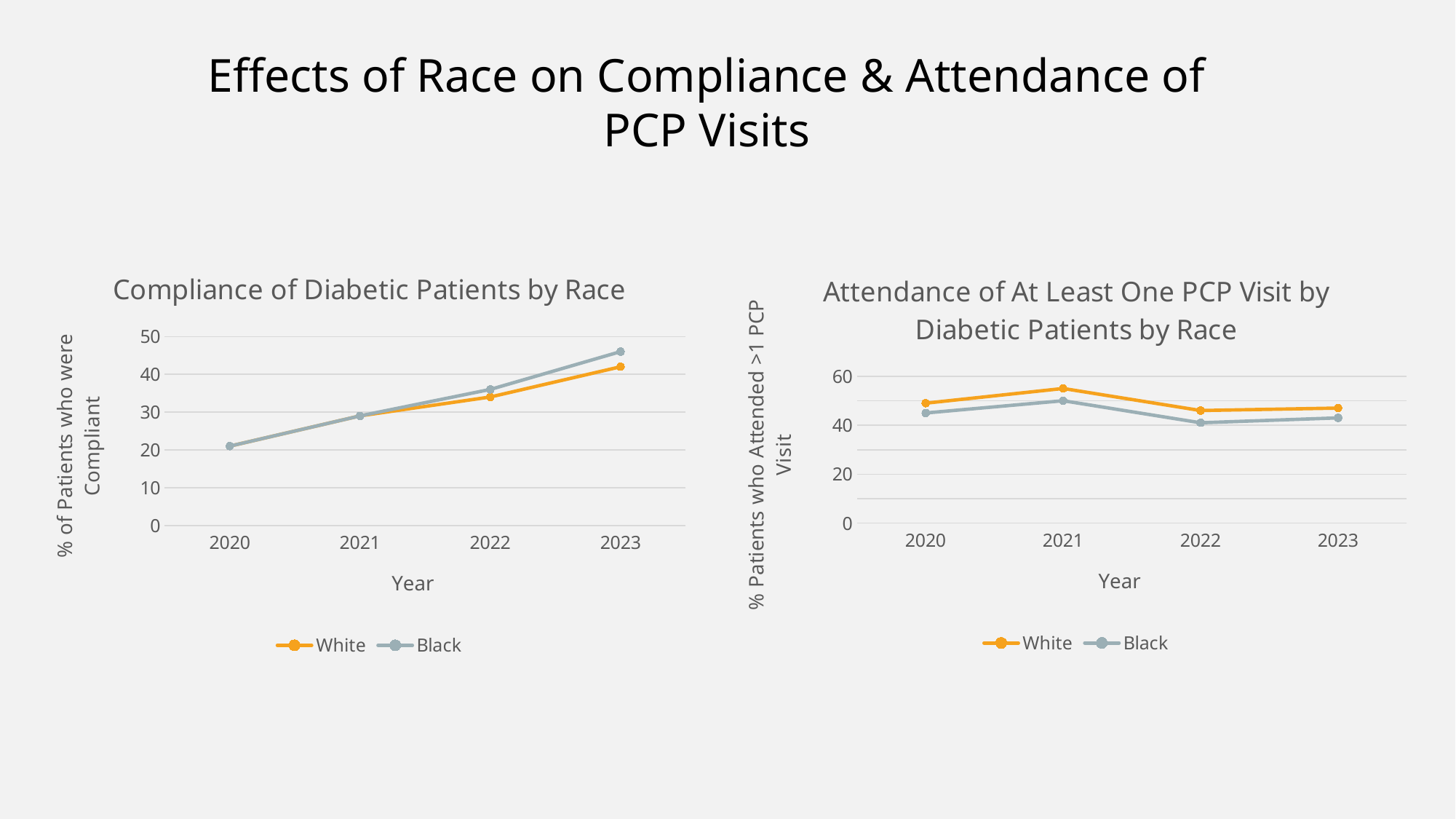
In the 'Compliance of Diabetic Patients by Race' chart, is the value for Black in 2023 greater or less than 40? greater How many series does the legend of the 'Attendance of At Least One PCP Visit by Diabetic Patients by Race' chart list? 2 In the 'Attendance of At Least One PCP Visit by Diabetic Patients by Race' chart, is the value for White in 2021 greater or less than 40? greater In the 'Attendance of At Least One PCP Visit by Diabetic Patients by Race' chart, which series has the higher value in 2021, White or Black? White In the 'Compliance of Diabetic Patients by Race' chart, is the value for White in 2020 greater or less than 30? less In the 'Compliance of Diabetic Patients by Race' chart, which series has the higher value in 2023, White or Black? Black In the 'Compliance of Diabetic Patients by Race' chart, in which year is the Black series highest? 2023 What is the x-axis label of the 'Attendance of At Least One PCP Visit by Diabetic Patients by Race' chart? Year What kind of chart is the 'Compliance of Diabetic Patients by Race' chart on the left? line chart In the 'Compliance of Diabetic Patients by Race' chart, do the values for White rise or fall from 2020 to 2023? rise How many years are plotted on the x axis of the 'Compliance of Diabetic Patients by Race' chart? 4 In the 'Attendance of At Least One PCP Visit by Diabetic Patients by Race' chart, in which year is the White series highest? 2021